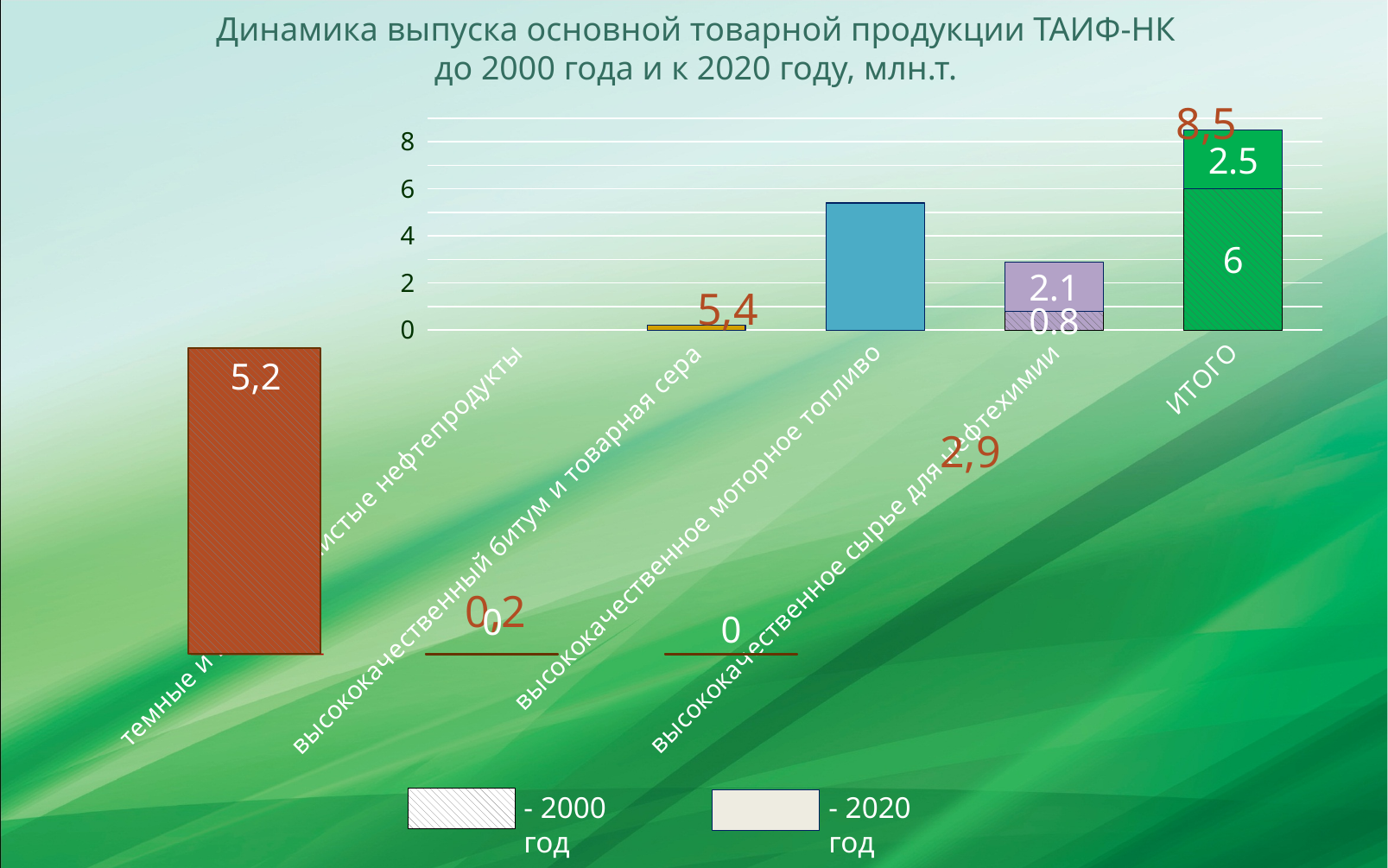
How many series does the legend list? 2 What is the 2000 год value for ИТОГО? 6 What is the 2000 год value for высококачественный битум и товарная сера? 0 What is the 2020 год value for ИТОГО? 2.5 What is the title of the chart? Динамика выпуска основной товарной продукции ТАИФ-НК до 2000 года и к 2020 году, млн.т. What are the two series named in the legend? 2000 год and 2020 год For ИТОГО, which is larger: the 2000 год value or the 2020 год value? 2000 год What is the 2020 год value for высококачественное сырье для нефтехимии? 2.1 What kind of chart is shown on the slide? bar chart How many categories are shown on the x axis? 5 What is the 2000 год value for высококачественное моторное топливо? 0 What is the total value labelled above the ИТОГО bar? 8,5